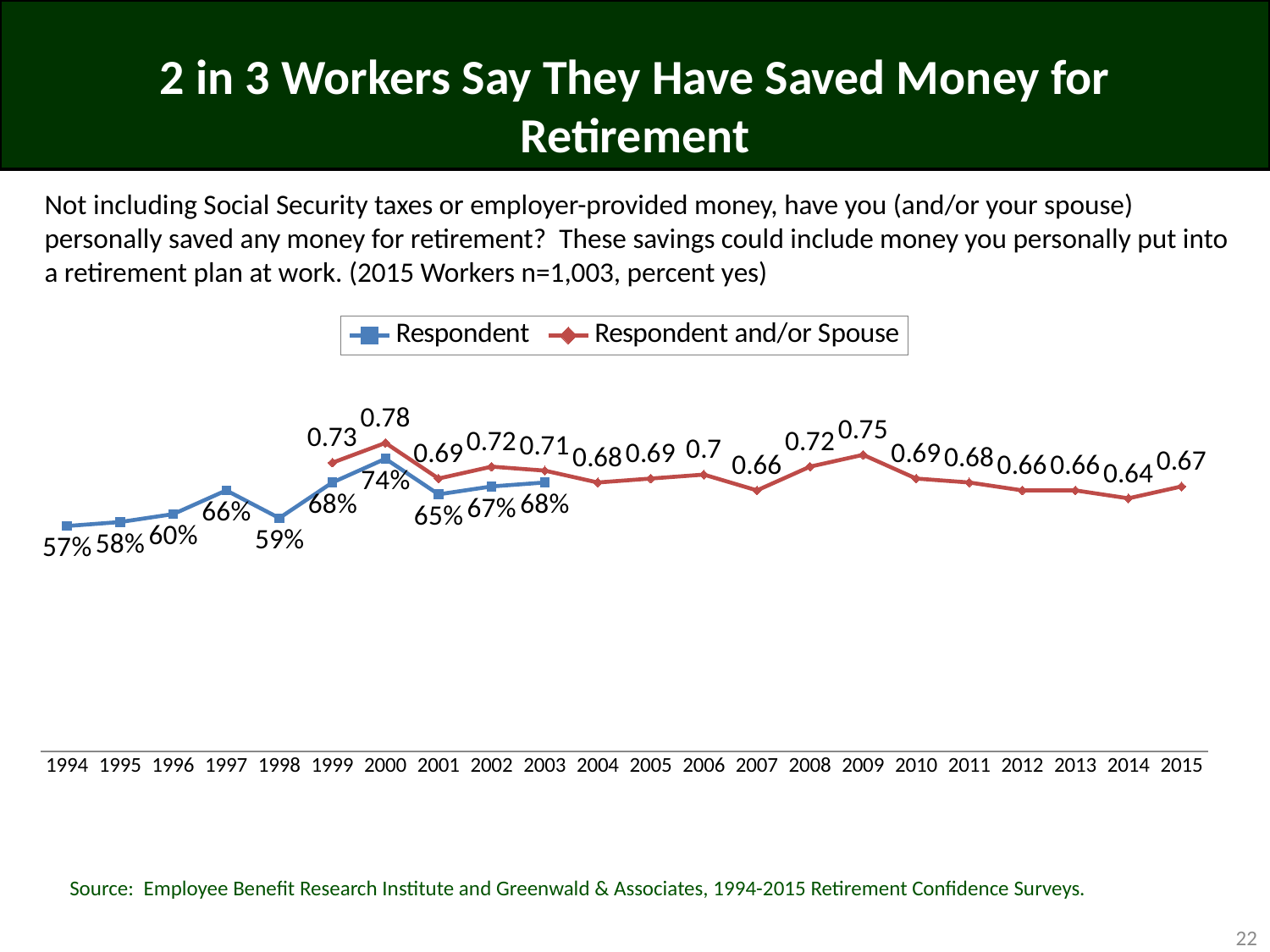
What kind of chart is shown on the slide? Line chart What is the value for Respondent in 1994? 57% What is the difference between the Respondent and/or Spouse values in 2000 and 2001? 0.09 In which year is the Respondent series lowest? 1994 How many years are shown on the x axis? 22 In which year is the Respondent and/or Spouse series lowest? 2014 How many series does the legend list? 2 In which year is the Respondent and/or Spouse series highest? 2000 Which is larger in 2001: the Respondent value or the Respondent and/or Spouse value? Respondent and/or Spouse What is the value for Respondent and/or Spouse in 2015? 0.67 What is the value for Respondent and/or Spouse in 2009? 0.75 What is the value for Respondent in 2000? 74%